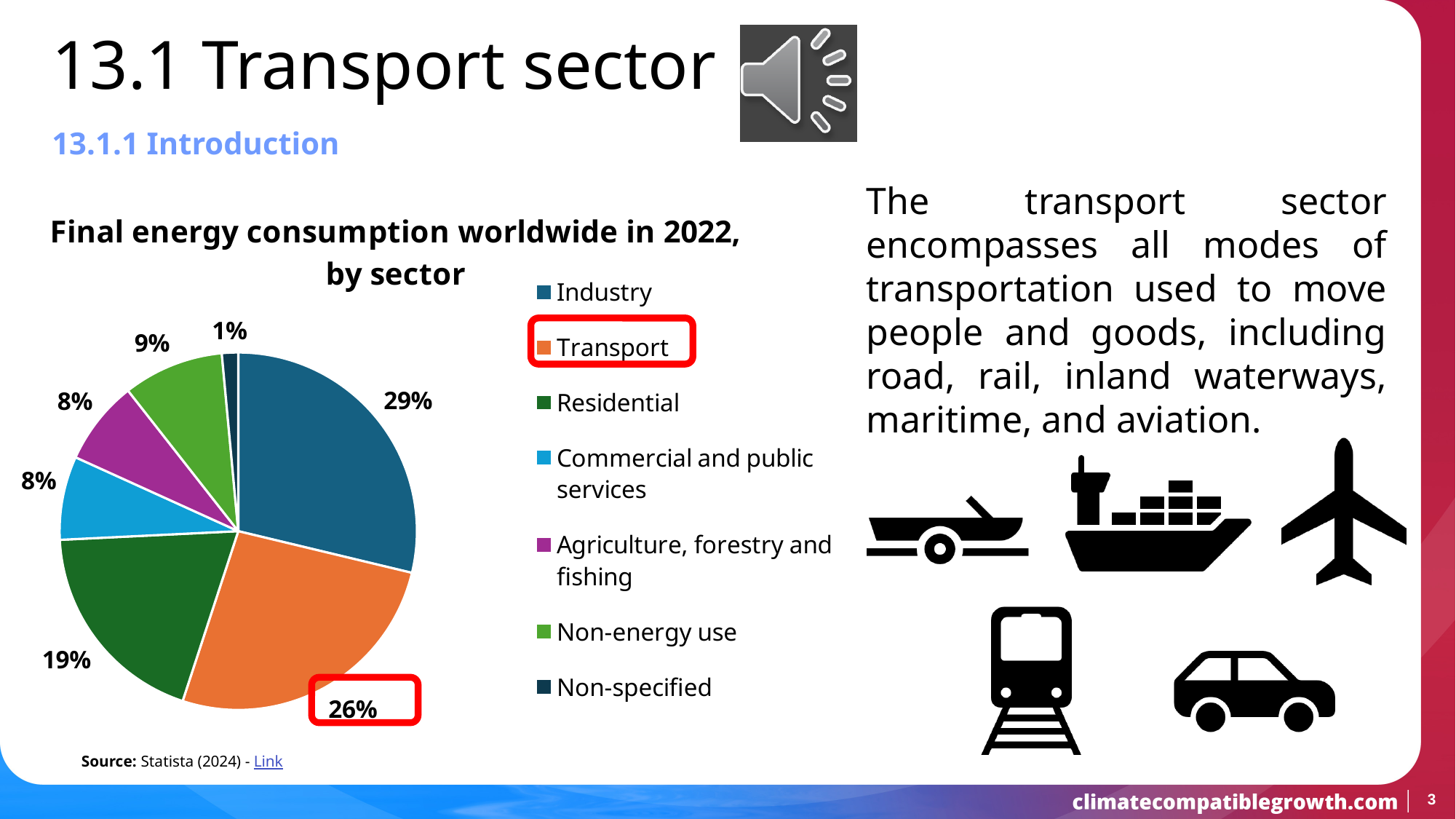
What is the difference in percentage points between the Industry share and the Transport share? 3 percentage points What type of chart is shown on the slide? Pie chart What share of final energy consumption worldwide in 2022 does Industry account for? 29% What share of final energy consumption worldwide in 2022 does the Transport sector account for? 26% What is the title of the chart? Final energy consumption worldwide in 2022, by sector How many sectors are listed in the chart's legend? 7 Which has a larger share of final energy consumption in 2022, Transport or Residential? Transport What share of final energy consumption worldwide in 2022 does the Residential sector account for? 19% Which sector has the smallest share of final energy consumption worldwide in 2022? Non-specified Which sector has the largest share of final energy consumption worldwide in 2022? Industry What share of final energy consumption worldwide in 2022 is Non-specified? 1% What share of final energy consumption worldwide in 2022 is Non-energy use? 9%